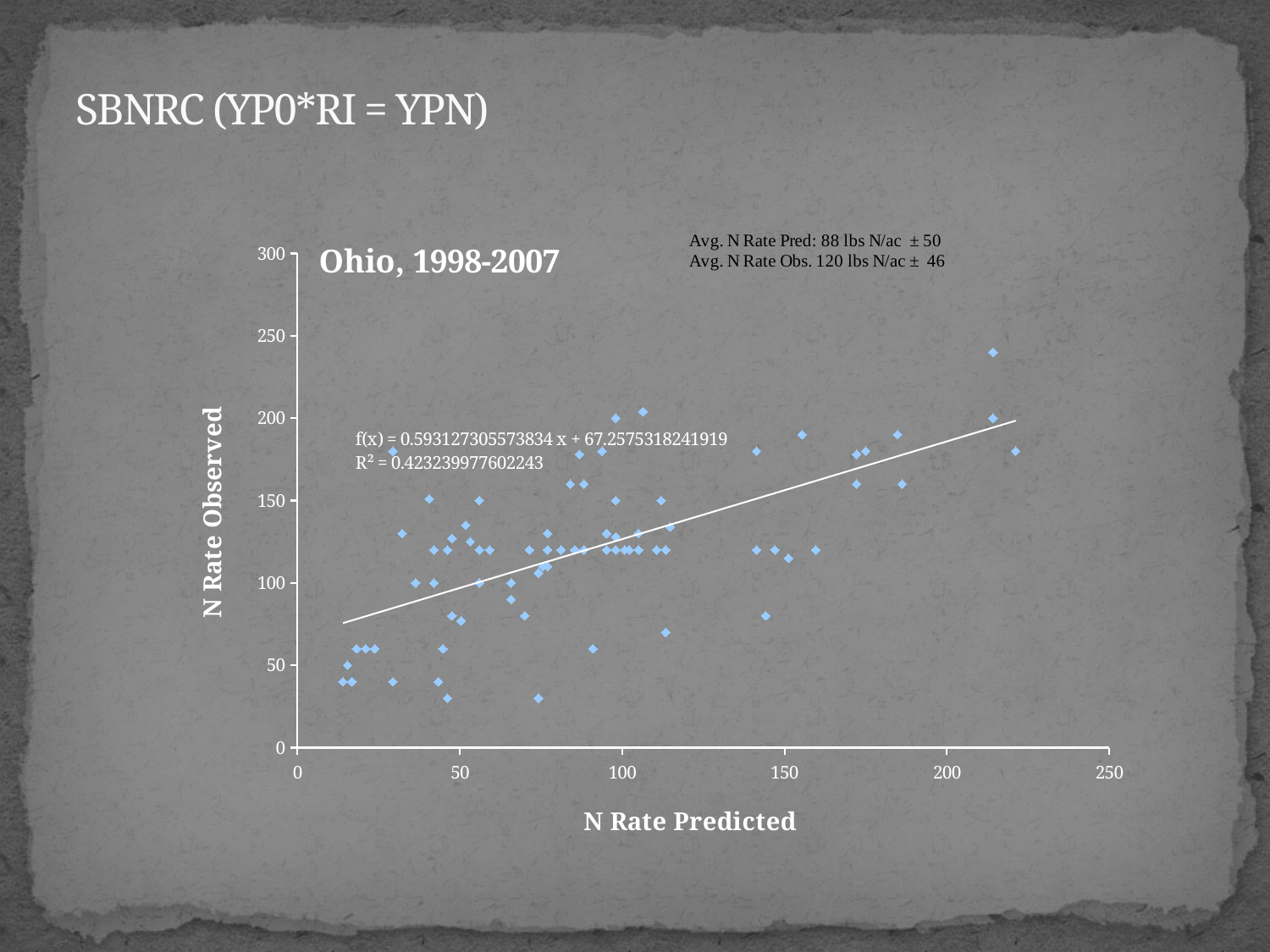
What is the average N Rate Predicted stated on the slide? 88 lbs N/ac ± 50 What kind of chart is shown on the slide? scatter plot What is the title of the chart? Ohio, 1998-2007 Does the fitted trend line rise or fall as N Rate Predicted increases? rises Is the highest N Rate Observed value plotted greater or less than 200? greater What is the slope of the fitted line f(x) printed on the chart? 0.593127305573834 What is the maximum value shown on the y axis? 300 What is the intercept of the fitted line f(x) printed on the chart? 67.2575318241919 Is the lowest N Rate Observed value plotted greater or less than 50? less What is the label of the x axis? N Rate Predicted What R² value is printed on the chart? 0.423239977602243 What is the average N Rate Observed stated on the slide? 120 lbs N/ac ± 46